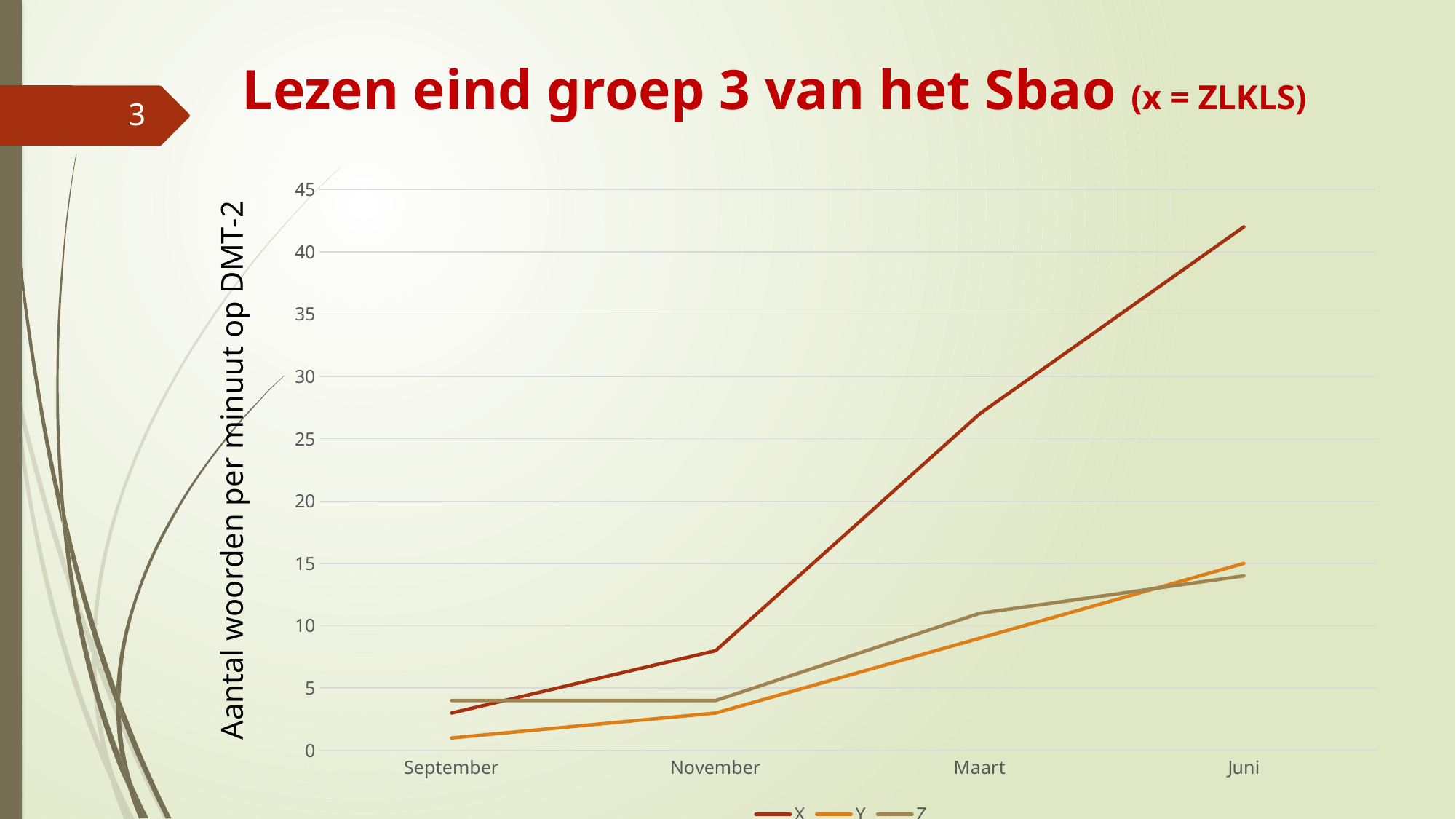
Is the value for series X in Maart greater or less than 25? greater How many months are shown along the x axis? 4 What kind of chart is shown on the slide? line chart Is the value for series Y in September greater or less than 5? less In Maart, which series has the larger value, Y or Z? Z Do the values for series X rise or fall from September to Juni? rise Is the value for series X in Juni greater or less than 40? greater Which series has the highest value in Juni? X In which month does series X reach its lowest value? September How many series does the legend list? 3 What is the title of the vertical axis? Aantal woorden per minuut op DMT-2